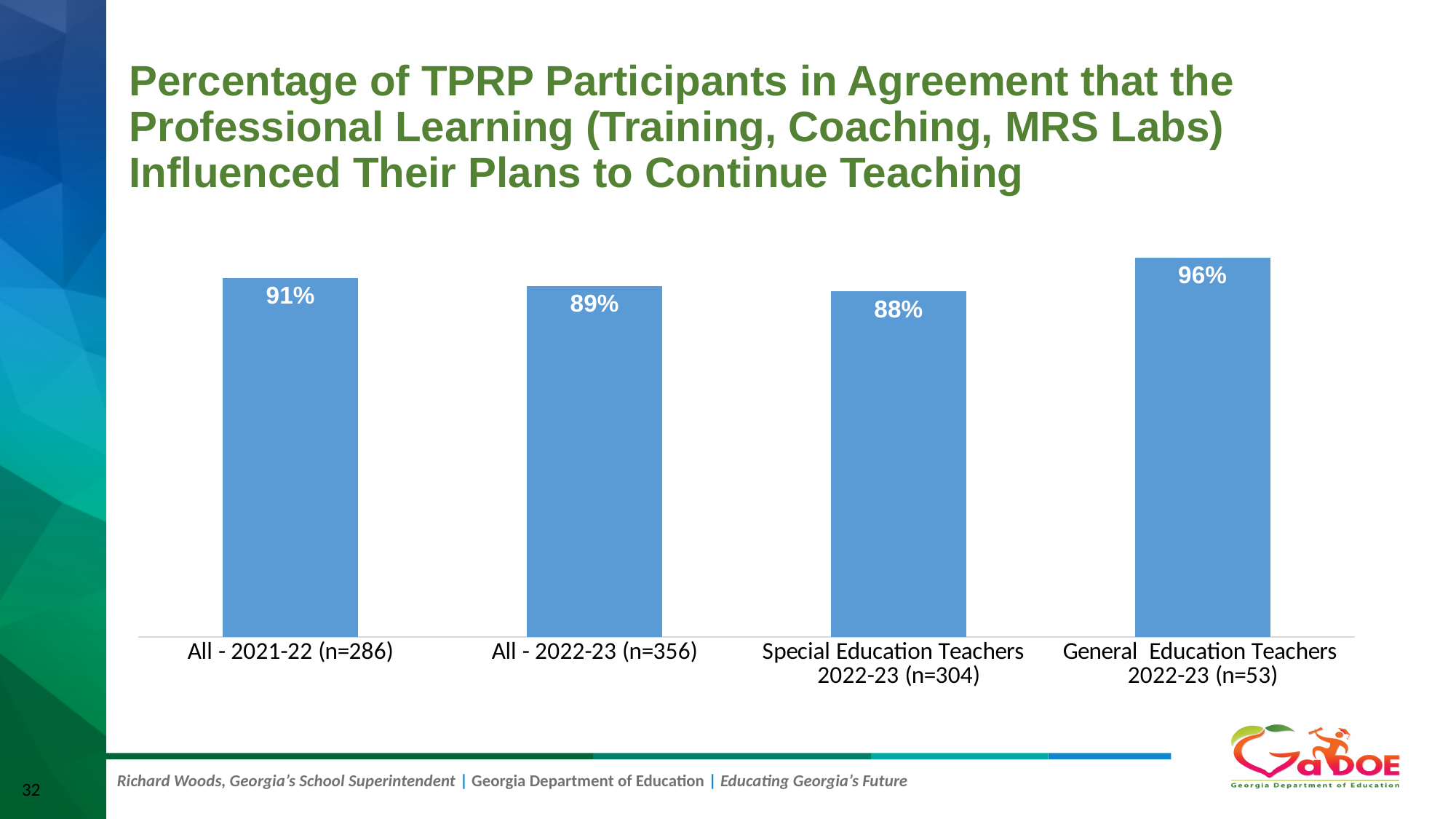
Which category has the highest percentage in agreement? General Education Teachers 2022-23 (n=53) Which category has the lowest percentage in agreement? Special Education Teachers 2022-23 (n=304) What is the difference in percentage points between All - 2021-22 and All - 2022-23? 2 What percentage is shown for Special Education Teachers 2022-23 (n=304)? 88% What percentage is shown for General Education Teachers 2022-23 (n=53)? 96% What type of chart is shown on the slide? Bar chart How many categories are shown in the chart? 4 What colour are the bars in the chart? Blue Which is larger: the value for All - 2021-22 (n=286) or the value for All - 2022-23 (n=356)? All - 2021-22 (n=286) What is the value shown for All - 2022-23 (n=356)? 89% What is the difference in percentage points between General Education Teachers 2022-23 and Special Education Teachers 2022-23? 8 What percentage of All - 2021-22 (n=286) participants agreed that the professional learning influenced their plans to continue teaching? 91%